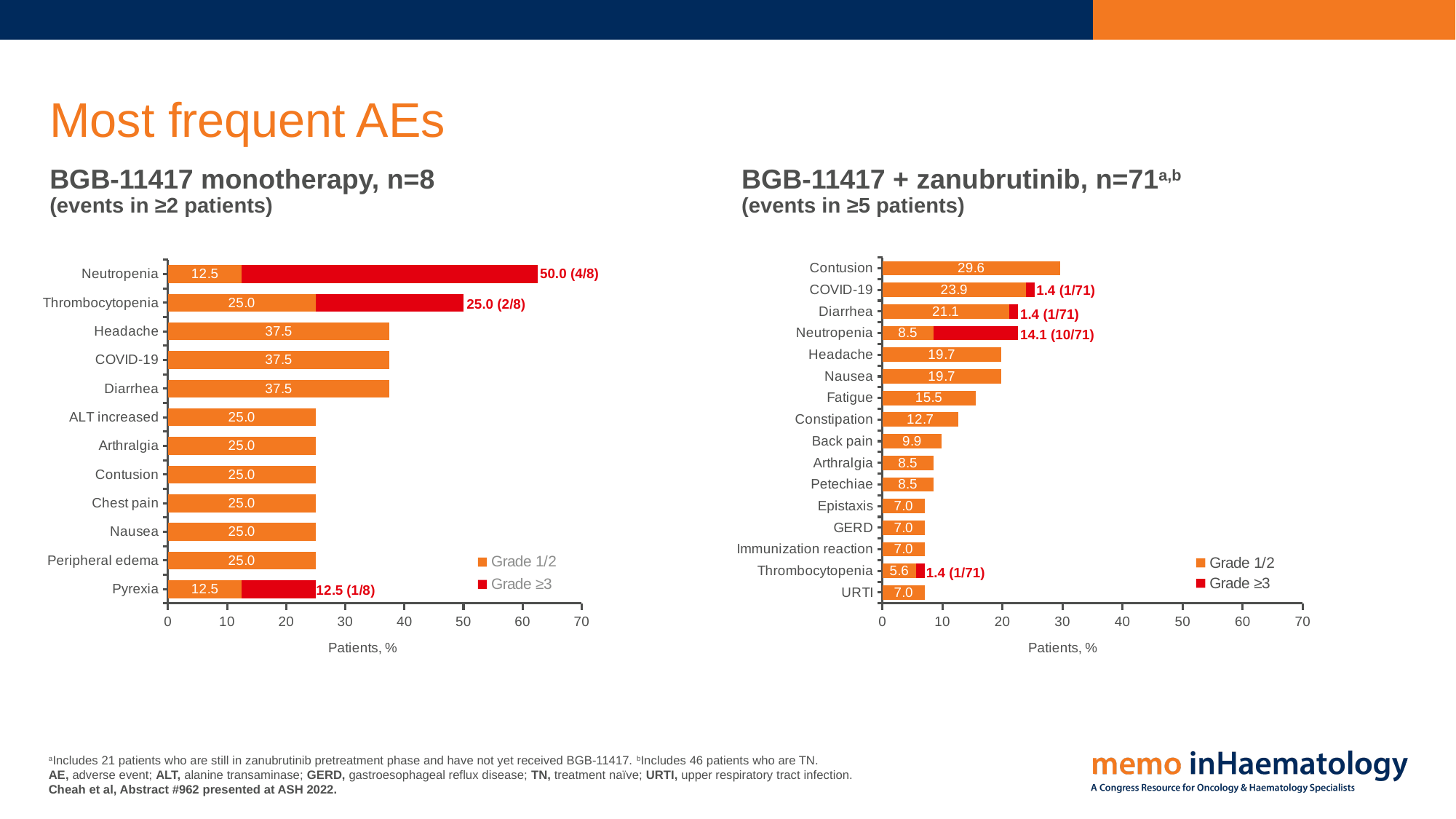
In the BGB-11417 monotherapy chart, what is the Grade ≥3 value for Neutropenia? 50.0 (4/8) In the BGB-11417 monotherapy chart, what is the Grade 1/2 value for Headache? 37.5 What type of chart is the BGB-11417 monotherapy chart? Stacked bar chart In the BGB-11417 + zanubrutinib chart, which is larger, the Grade 1/2 value for Back pain or for Constipation? Constipation In the BGB-11417 + zanubrutinib chart, which adverse event has the highest Grade 1/2 value? Contusion In the BGB-11417 monotherapy chart, what is the total of the stacked bar for Neutropenia? 62.5 In the BGB-11417 monotherapy chart, how many adverse event categories are listed? 12 In the BGB-11417 monotherapy chart, what is the Grade 1/2 value for Pyrexia? 12.5 In the BGB-11417 + zanubrutinib chart, what is the Grade ≥3 value for Neutropenia? 14.1 (10/71) How many series does the legend of the BGB-11417 + zanubrutinib chart list? 2 In the BGB-11417 + zanubrutinib chart, how many adverse event categories are listed? 16 In the BGB-11417 + zanubrutinib chart, what is the difference between the Grade 1/2 values for Contusion and Fatigue? 14.1